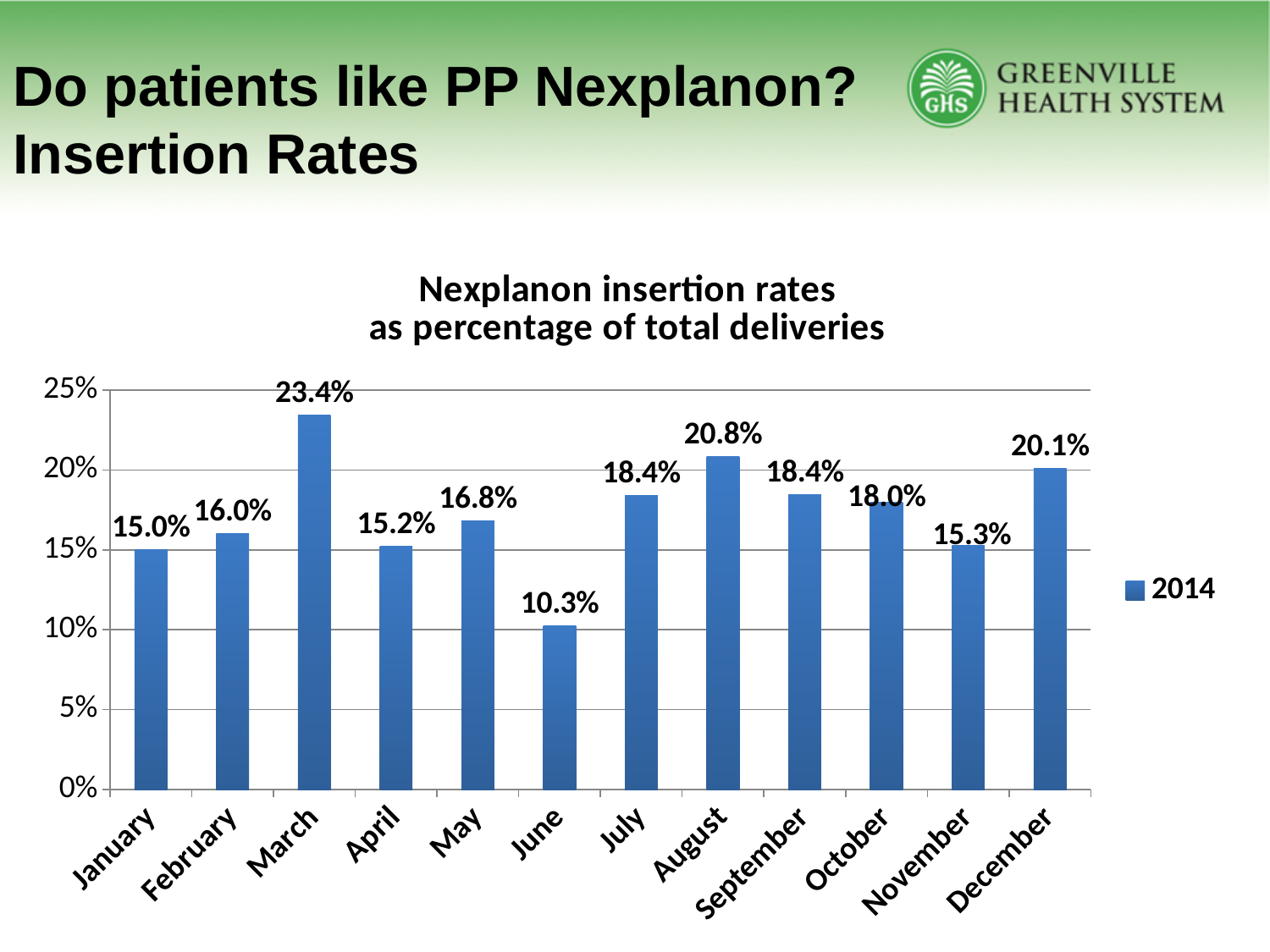
What is the Nexplanon insertion rate for June? 10.3% Which month has a higher insertion rate, October or November? October What kind of chart is shown on the slide? Bar chart What year does the legend show for the data series? 2014 What is the Nexplanon insertion rate for March? 23.4% What is the Nexplanon insertion rate for December? 20.1% Which month has the lowest Nexplanon insertion rate? June What is the difference between the insertion rates for August and July? 2.4% What is the difference between the insertion rates for March and June? 13.1% How many months are shown on the chart? 12 Which month has the highest Nexplanon insertion rate? March Is the insertion rate for August greater or less than 20%? greater